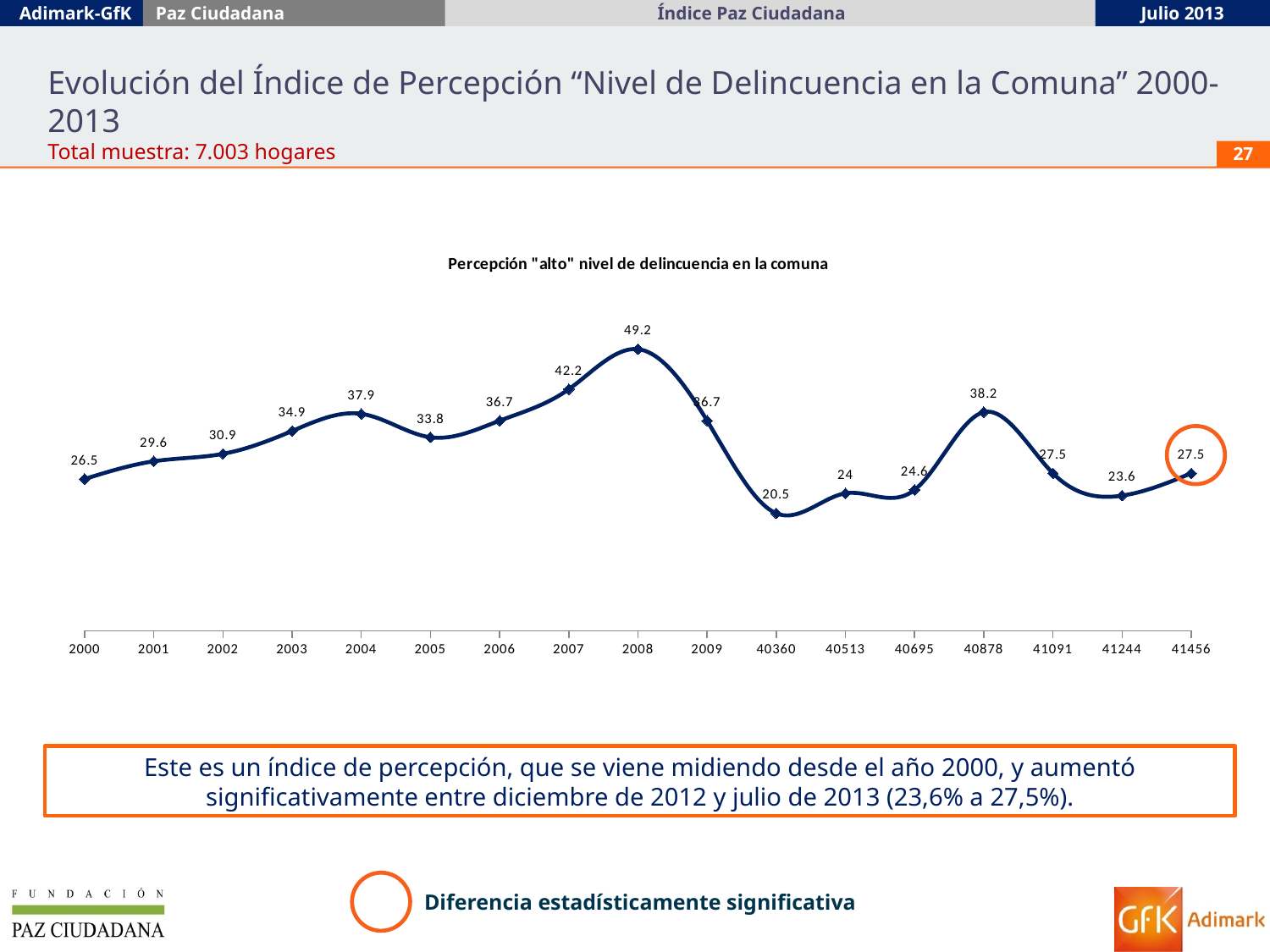
Which x-axis category has the lowest value? 40360 What is the value plotted for 2008? 49.2 Which is larger, the value for 2003 or the value for 2005? 2003 What is the value plotted for 2000? 26.5 Which x-axis category has the highest value? 2008 What is the value plotted for 2004? 37.9 Do the values rise or fall from 2000 to 2004? Rise What kind of chart is shown on the slide? Line chart What is the difference between the values for 2008 and 2007? 7 How many data points are plotted on the line? 17 What is the difference between the values for 2001 and 2000? 3.1 What is the title of the chart? Percepción "alto" nivel de delincuencia en la comuna